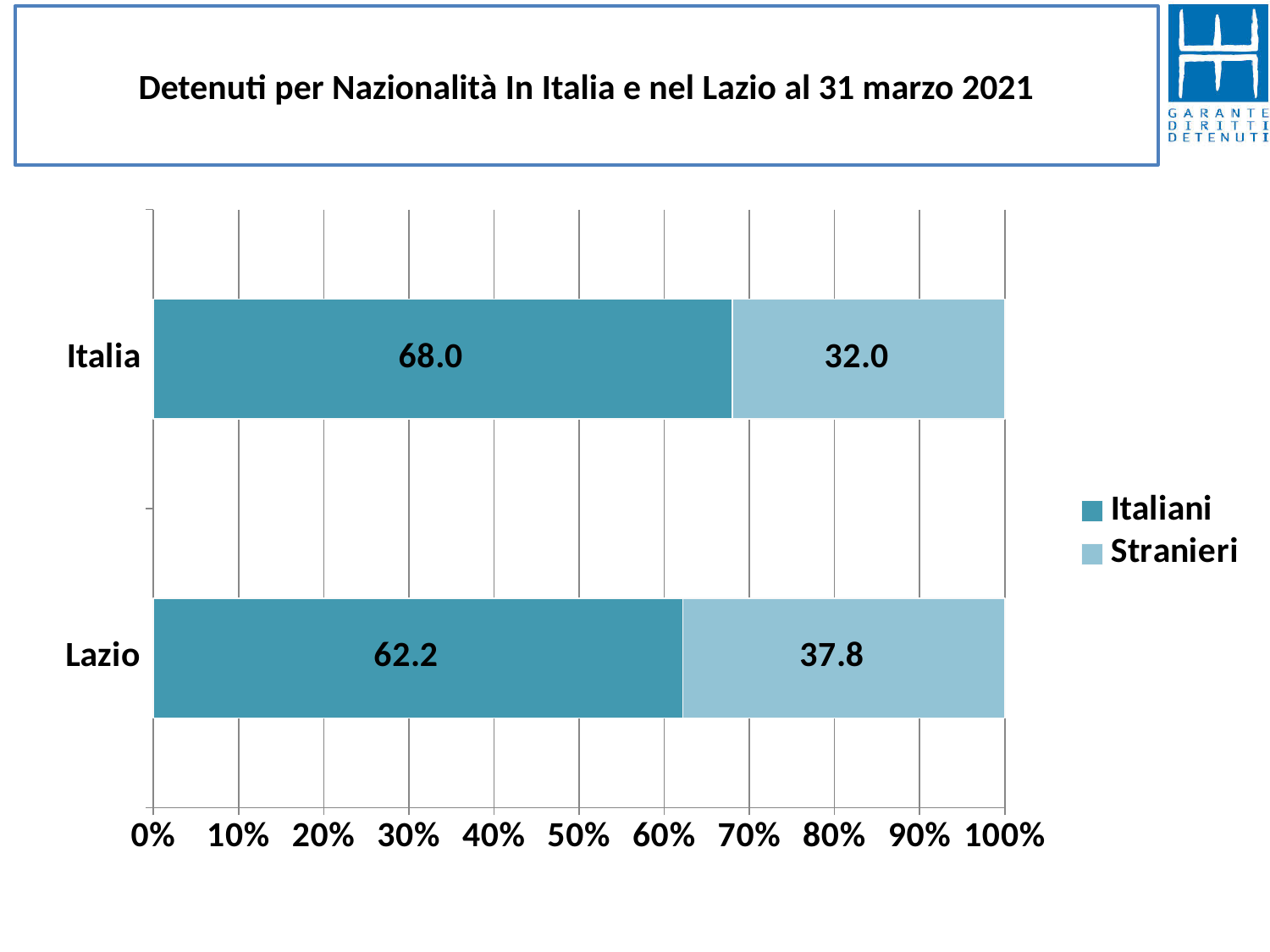
What is the total of the stacked bar for Italia? 100.0 Which category has the higher Stranieri value, Italia or Lazio? Lazio What is the value for Italiani in Italia? 68.0 How many series does the legend list? 2 How many categories are shown on the chart? 2 Which category has the higher Italiani value, Italia or Lazio? Italia What kind of chart is shown on the slide? Stacked bar chart What is the difference between the Italiani values for Italia and Lazio? 5.8 What is the difference between the Italiani and Stranieri values for Lazio? 24.4 What is the value for Italiani in Lazio? 62.2 What is the value for Stranieri in Italia? 32.0 What is the value for Stranieri in Lazio? 37.8